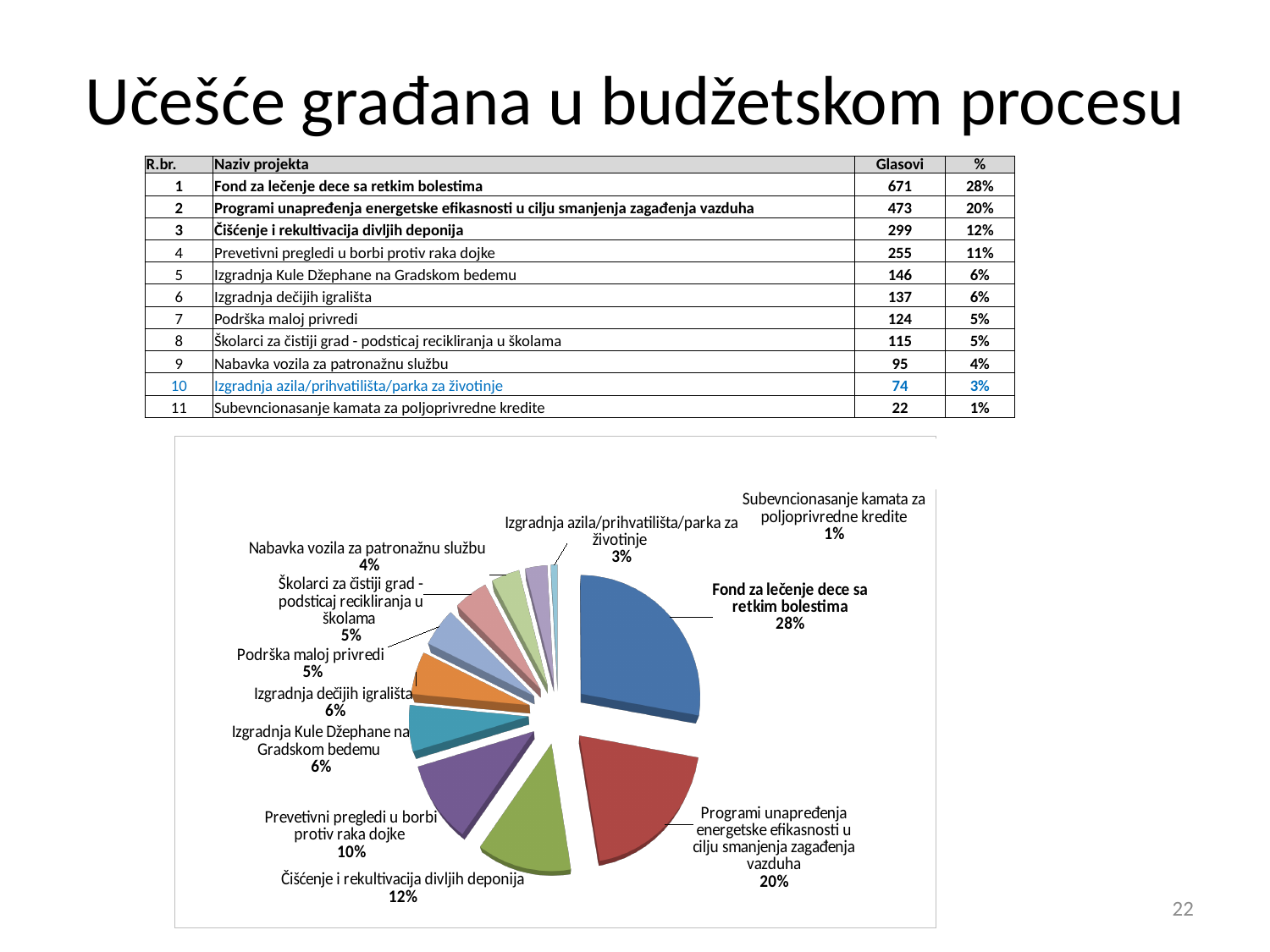
Which slice of the pie chart has the smallest share? Subevncionasanje kamata za poljoprivredne kredite What is the title of the slide containing the pie chart? Učešće građana u budžetskom procesu What is the difference in percentage points between 'Fond za lečenje dece sa retkim bolestima' and 'Programi unapređenja energetske efikasnosti u cilju smanjenja zagađenja vazduha' in the pie chart? 8% What percentage is shown for 'Izgradnja azila/prihvatilišta/parka za životinje' in the pie chart? 3% What share of the pie does 'Fond za lečenje dece sa retkim bolestima' have? 28% Which has the larger share in the pie chart: 'Izgradnja dečijih igrališta' or 'Nabavka vozila za patronažnu službu'? Izgradnja dečijih igrališta What share of the pie does 'Programi unapređenja energetske efikasnosti u cilju smanjenja zagađenja vazduha' have? 20% What percentage is shown for 'Čišćenje i rekultivacija divljih deponija' in the pie chart? 12% How many slices does the pie chart have? 11 What kind of chart is shown on the slide? pie chart What percentage is shown for 'Nabavka vozila za patronažnu službu' in the pie chart? 4% Which slice of the pie chart has the largest share? Fond za lečenje dece sa retkim bolestima